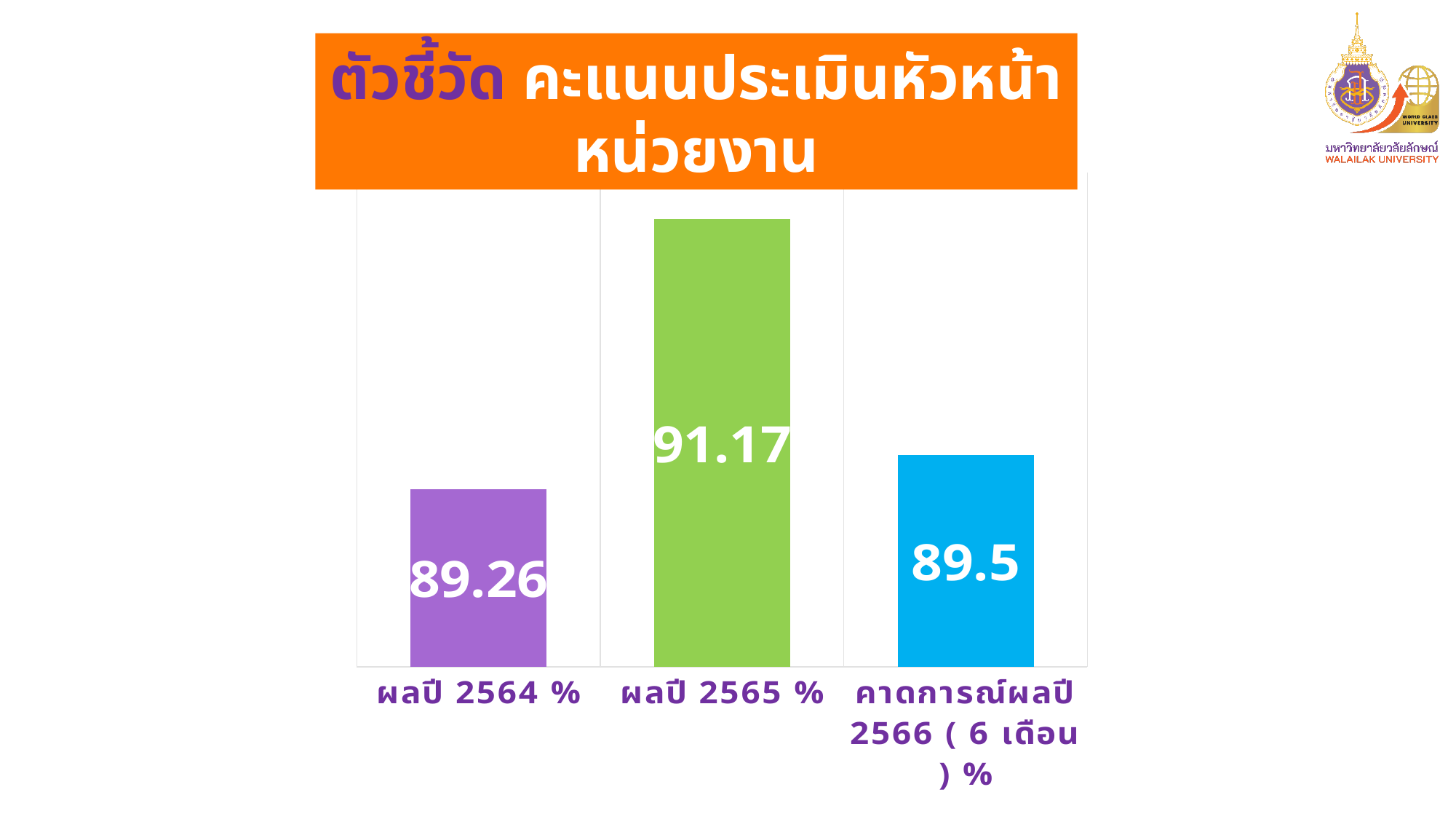
What colour is the bar for ผลปี 2565 %? Green What is the title of the chart? ตัวชี้วัด คะแนนประเมินหัวหน้าหน่วยงาน What is the difference between the values for ผลปี 2565 % and ผลปี 2564 %? 1.91 What is the value for ผลปี 2565 %? 91.17 What is the value for คาดการณ์ผลปี 2566 ( 6 เดือน ) %? 89.5 How many categories are shown in the chart? 3 Which category has the lowest value? ผลปี 2564 % Which is larger, the value for ผลปี 2564 % or the value for คาดการณ์ผลปี 2566 ( 6 เดือน ) %? คาดการณ์ผลปี 2566 ( 6 เดือน ) % Which category has the highest value? ผลปี 2565 % What kind of chart is shown on the slide? Bar chart What is the value for ผลปี 2564 %? 89.26 What is the difference between the values for ผลปี 2565 % and คาดการณ์ผลปี 2566 ( 6 เดือน ) %? 1.67